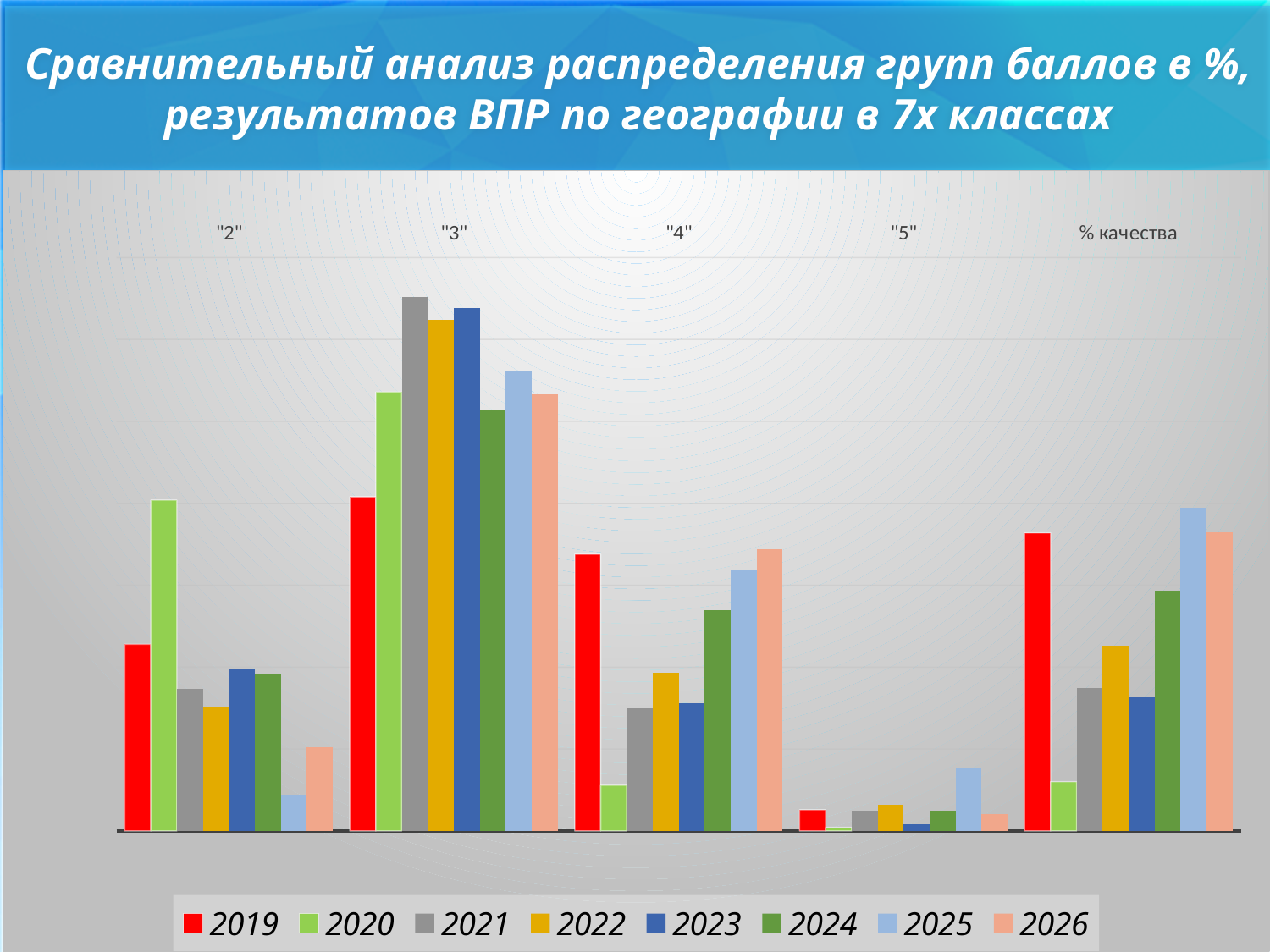
In the "5" category, which year has the highest bar? 2025 In the "3" category, which is larger: the bar for 2021 or the bar for 2020? 2021 What kind of chart is shown on the slide? bar chart In the "3" category, which year has the lowest bar? 2019 How many series does the legend list? 8 Which year is shown in red in the legend? 2019 How many categories are shown along the x axis? 5 In the "4" category, which year has the lowest bar? 2020 In the "4" category, which is larger: the bar for 2024 or the bar for 2022? 2024 In the "2" category, which year has the highest bar? 2020 In the "2" category, which year has the lowest bar? 2025